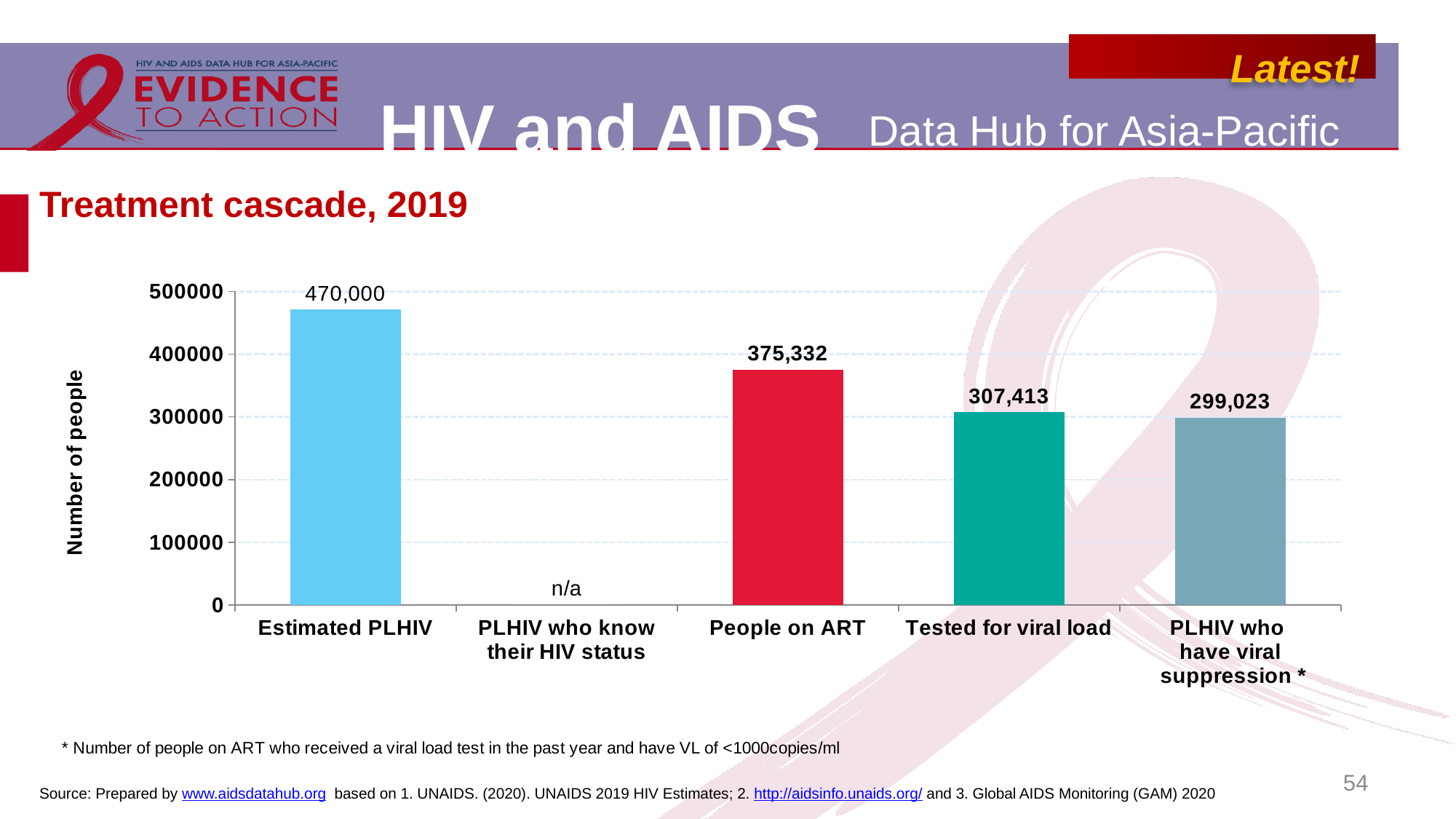
What is the value for People on ART? 375,332 What is shown for the category PLHIV who know their HIV status? n/a What is the value for PLHIV who have viral suppression? 299,023 What is the value for Estimated PLHIV? 470,000 How many categories are shown on the x axis? 5 What is the value for Tested for viral load? 307,413 What kind of chart is this? Bar chart What is the difference between Tested for viral load and PLHIV who have viral suppression? 8,390 Which is larger, People on ART or Tested for viral load? People on ART Which category has the highest value? Estimated PLHIV What is the difference between Estimated PLHIV and People on ART? 94,668 Which plotted bar has the lowest value? PLHIV who have viral suppression